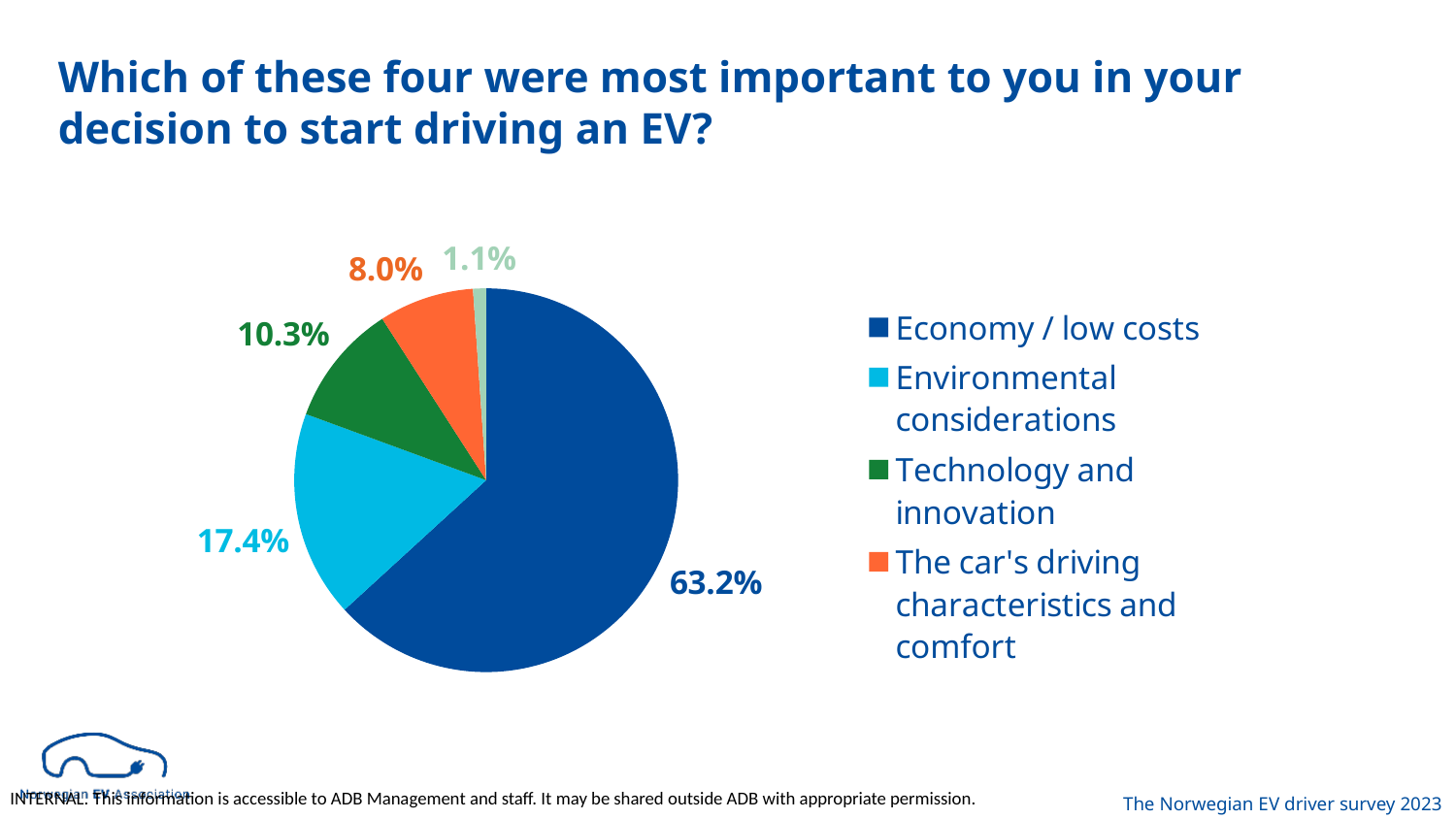
Which category has the largest slice of the pie? Economy / low costs What share of the pie does Economy / low costs have? 63.2% What is the value for Environmental considerations? 17.4% What is the value for Technology and innovation? 10.3% Which is larger, Environmental considerations or Technology and innovation? Environmental considerations What is the difference between the Economy / low costs slice and the Environmental considerations slice? 45.8% How many slices does the pie chart have? 5 What is the value for The car's driving characteristics and comfort? 8.0% What is the difference between the Technology and innovation slice and the car's driving characteristics and comfort slice? 2.3% How many entries does the legend list? 4 Which of the legend categories has the smallest slice? The car's driving characteristics and comfort What kind of chart is shown on the slide? Pie chart